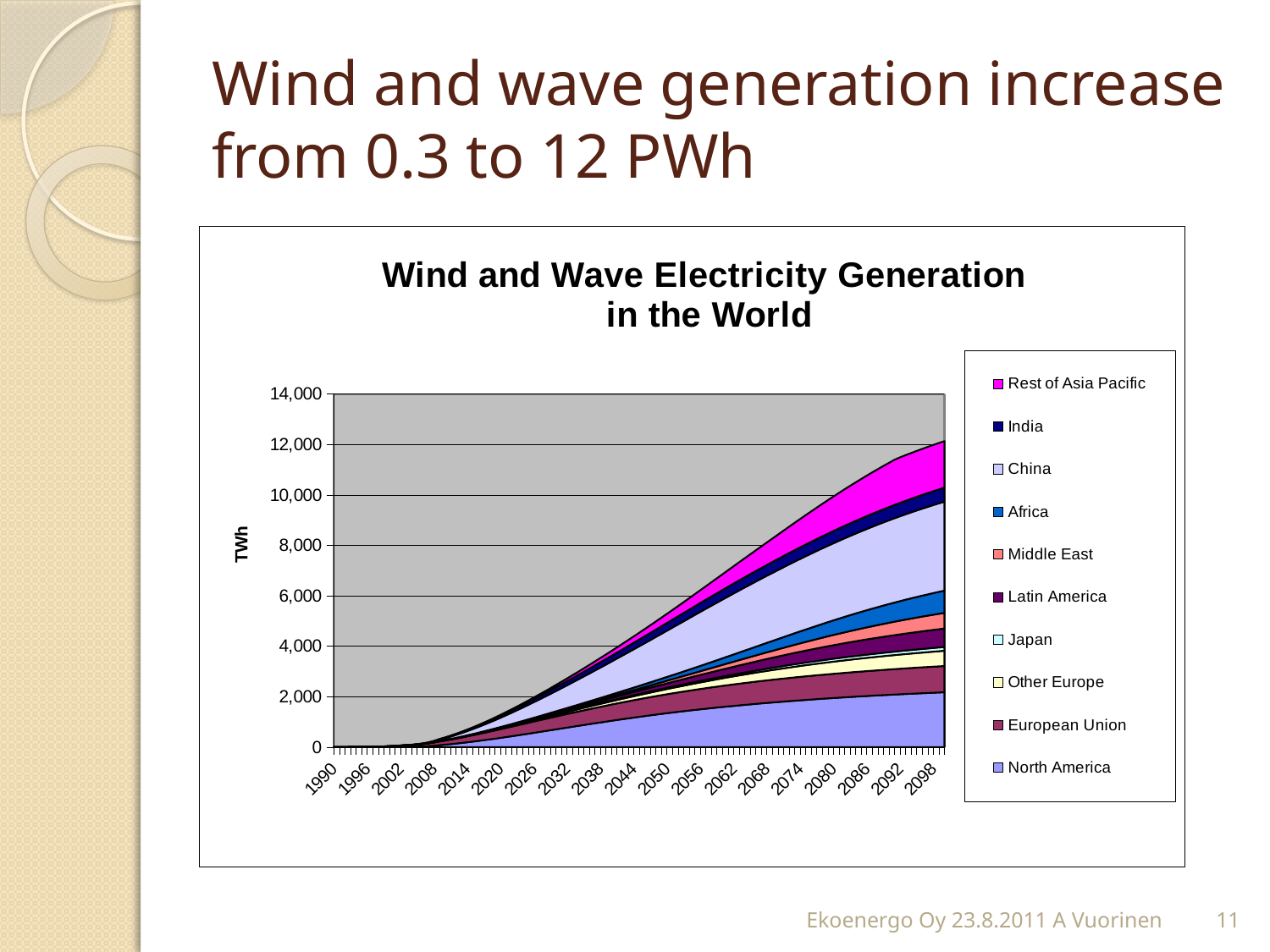
Is the generation for North America in 2098 greater or less than 4,000 TWh? less Which region contributes the smallest share of generation in 2098? Japan Which region contributes the largest share of generation in 2098? China Does total wind and wave generation rise or fall from 1990 to 2098? Rises Is the total generation in 2098 greater or less than 14,000 TWh? less How many series does the legend list? 10 In 2098, which region has the larger generation, China or Japan? China What is the title of the chart? Wind and Wave Electricity Generation in the World Is the total generation in 2050 greater or less than 2,000 TWh? greater What kind of chart is shown on the slide? Stacked area chart What unit is shown on the vertical axis label? TWh